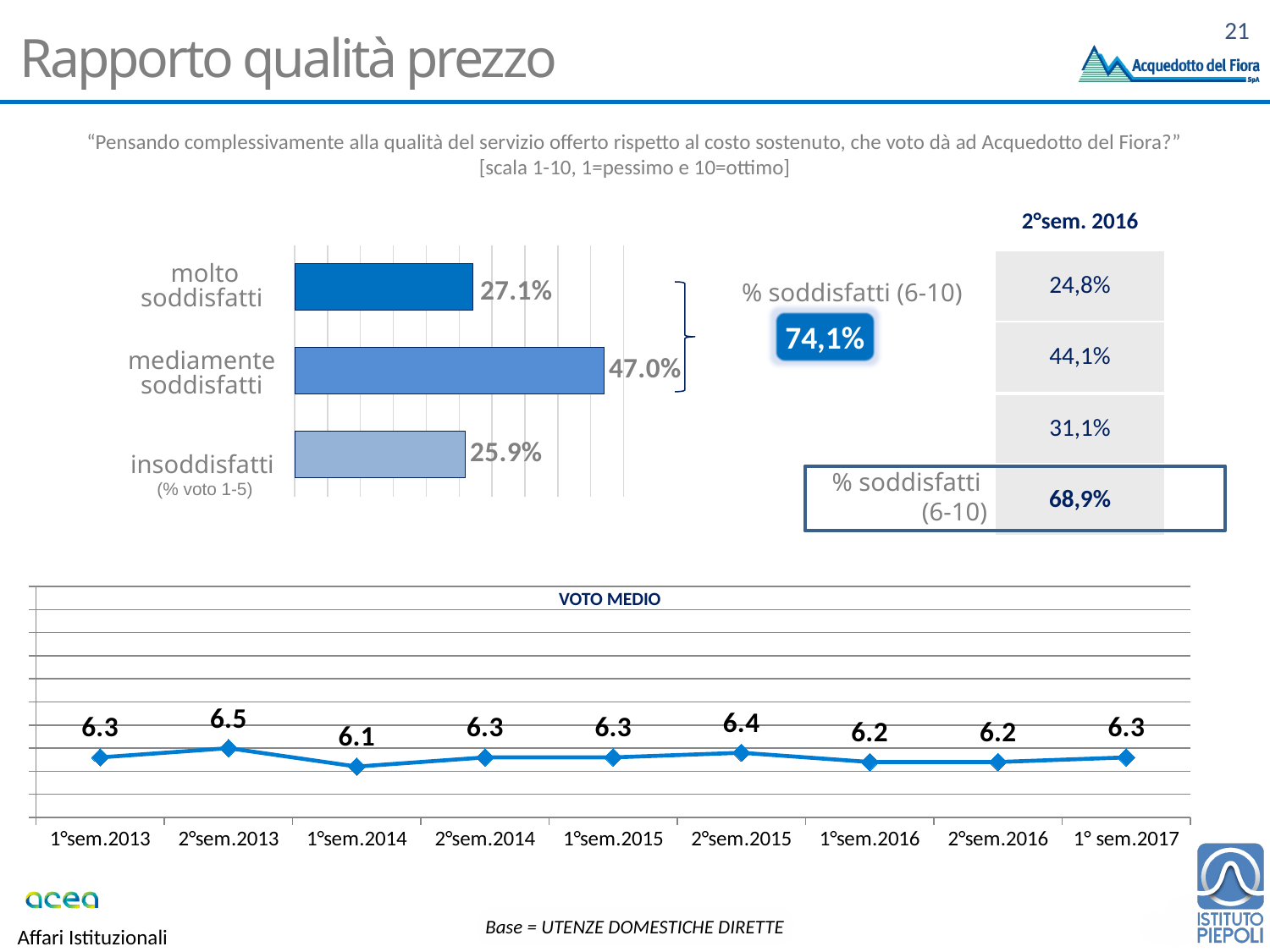
In the VOTO MEDIO chart, what is the value for 2°sem.2013? 6.5 How many data points does the VOTO MEDIO line chart show? 9 In the horizontal bar chart, what is the difference between "mediamente soddisfatti" and "molto soddisfatti"? 19.9% In the horizontal bar chart, what is the value for "insoddisfatti"? 25.9% In the horizontal bar chart, which category has the lowest value? insoddisfatti In the VOTO MEDIO chart, which period has the lowest value? 1°sem.2014 In the horizontal bar chart, which category has the highest value? mediamente soddisfatti In the horizontal bar chart, what is the value for "mediamente soddisfatti"? 47.0% What kind of chart is the chart at the top left of the slide? bar chart How many categories does the horizontal bar chart show? 3 In the VOTO MEDIO chart, which is larger: the value for 2°sem.2015 or the value for 1°sem.2016? 2°sem.2015 In the VOTO MEDIO chart, what is the value for 1° sem.2017? 6.3